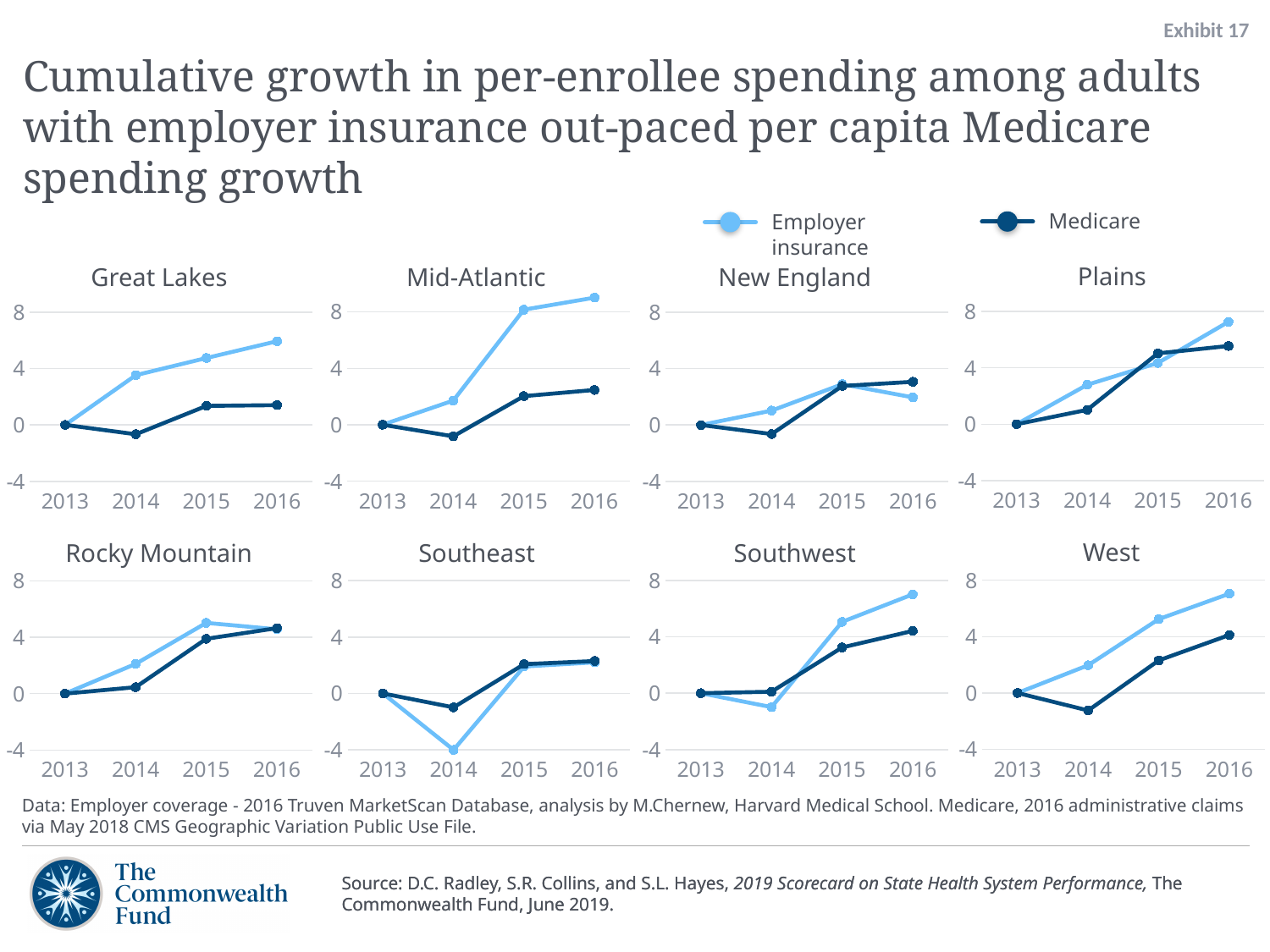
In the Mid-Atlantic chart, which series has the larger value in 2016, Employer insurance or Medicare? Employer insurance Which series is drawn in the darker blue colour in the legend? Medicare In the New England chart, which series has the larger value in 2016, Employer insurance or Medicare? Medicare In the Great Lakes chart, is the Employer insurance value for 2016 greater or less than 4? greater In the Mid-Atlantic chart, what is the Employer insurance value for 2013? 0 In the Great Lakes chart, how many years are plotted on the x axis? 4 In the Mid-Atlantic chart, does the Employer insurance series rise or fall from 2013 to 2016? rise What kind of chart is used for each region on the slide? line chart How many series does the legend list? 2 In the Southeast chart, is the Employer insurance value for 2014 greater or less than 0? less In the Mid-Atlantic chart, is the Employer insurance value for 2016 greater or less than 8? greater How many regional charts are shown on the slide? 8